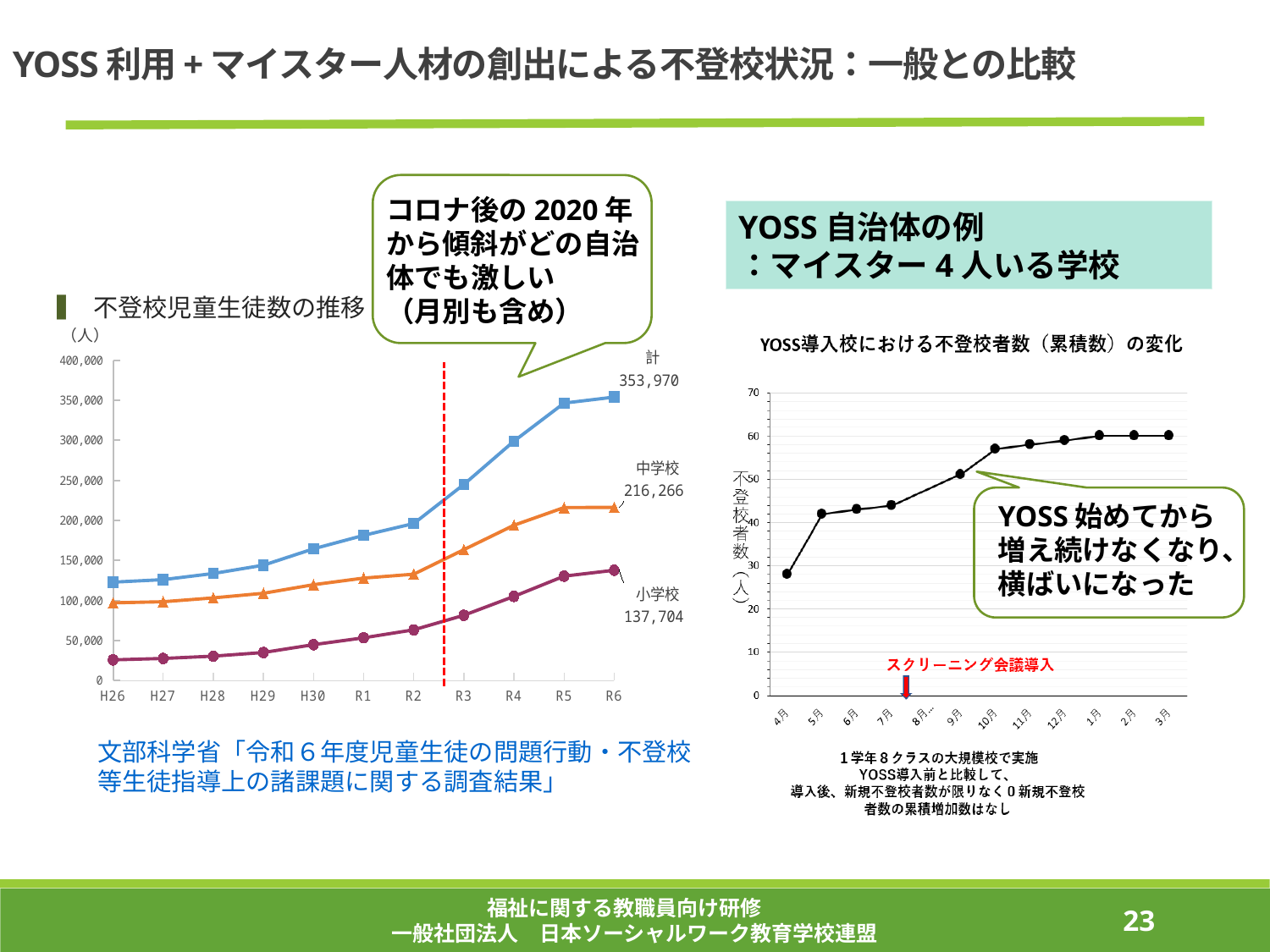
In the right chart YOSS導入校における不登校者数（累積数）の変化, is the value for 10月 greater or less than 50? greater In the left chart 不登校児童生徒数の推移, what is the value of 計 at R6? 353,970 In the left chart 不登校児童生徒数の推移, which is larger at R6, 中学校 or 小学校? 中学校 In the left chart 不登校児童生徒数の推移, is the value for 小学校 at R2 greater or less than 100,000? less In the left chart 不登校児童生徒数の推移, what is the difference between 中学校 and 小学校 at R6? 78,562 In the left chart 不登校児童生徒数の推移, what is the value of 小学校 at R6? 137,704 In the left chart 不登校児童生徒数の推移, do the values rise or fall from H26 to R6? rise In the right chart YOSS導入校における不登校者数（累積数）の変化, is the value for 4月 greater or less than 40? less What kind of chart is the left chart 不登校児童生徒数の推移? line chart In the right chart YOSS導入校における不登校者数（累積数）の変化, how many months are shown on the x axis? 12 In the left chart 不登校児童生徒数の推移, what is the value of 中学校 at R6? 216,266 In the left chart 不登校児童生徒数の推移, how many years are shown on the x axis? 11